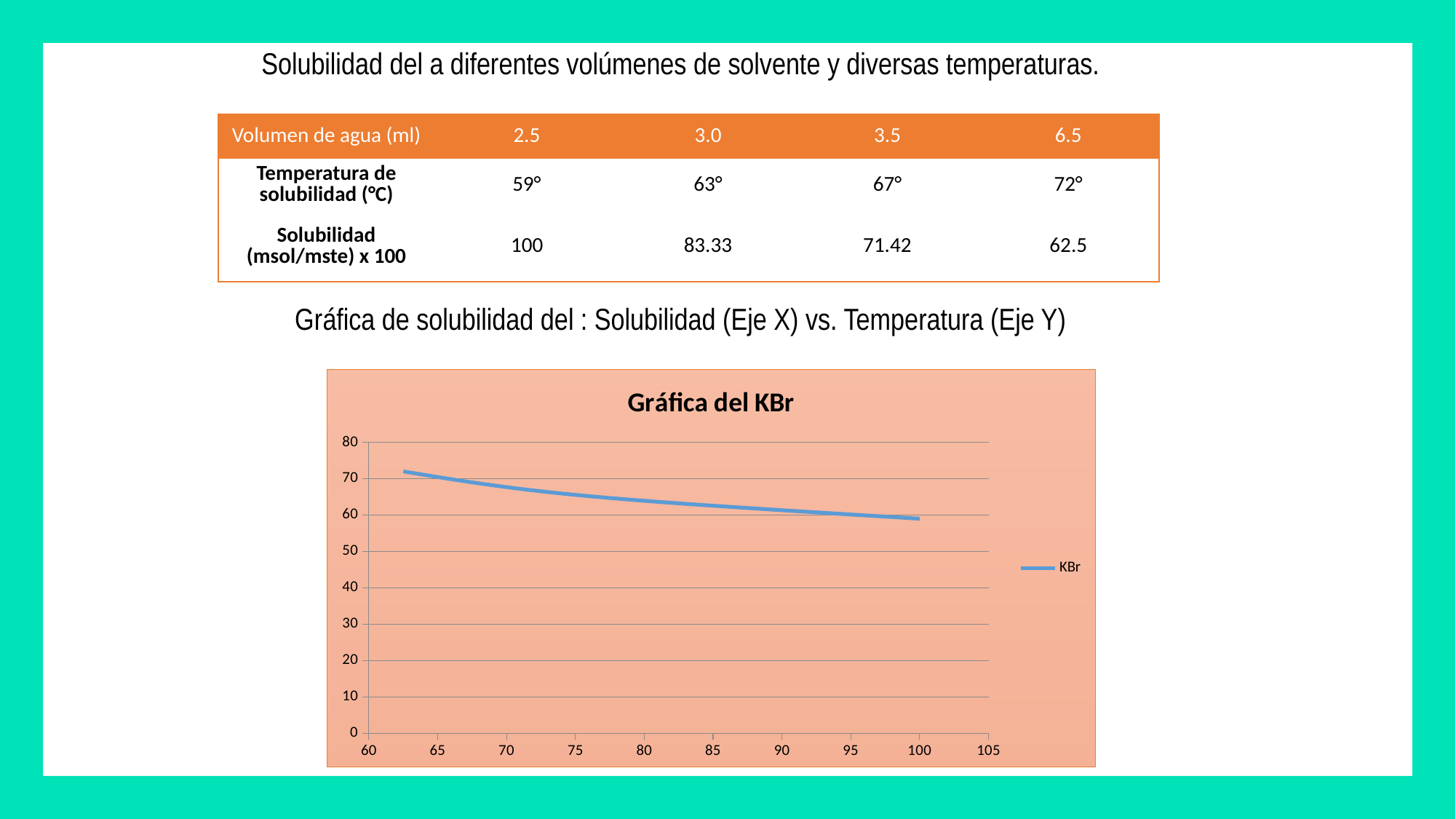
Is the value of the KBr line at x = 90 greater or less than 70? less Is the value of the KBr line at x = 70 greater or less than 60? greater Is the value of the KBr line at x = 80 greater or less than 60? greater How many series does the chart legend list? 1 What is the name of the series shown in the chart legend? KBr What is the title of the chart? Gráfica del KBr Is the KBr value at x = 70 larger or smaller than the KBr value at x = 95? larger What kind of chart is shown on the slide? line chart Does the KBr line rise or fall as the x-axis value increases from 60 to 100? fall What is the highest value shown on the chart's y axis? 80